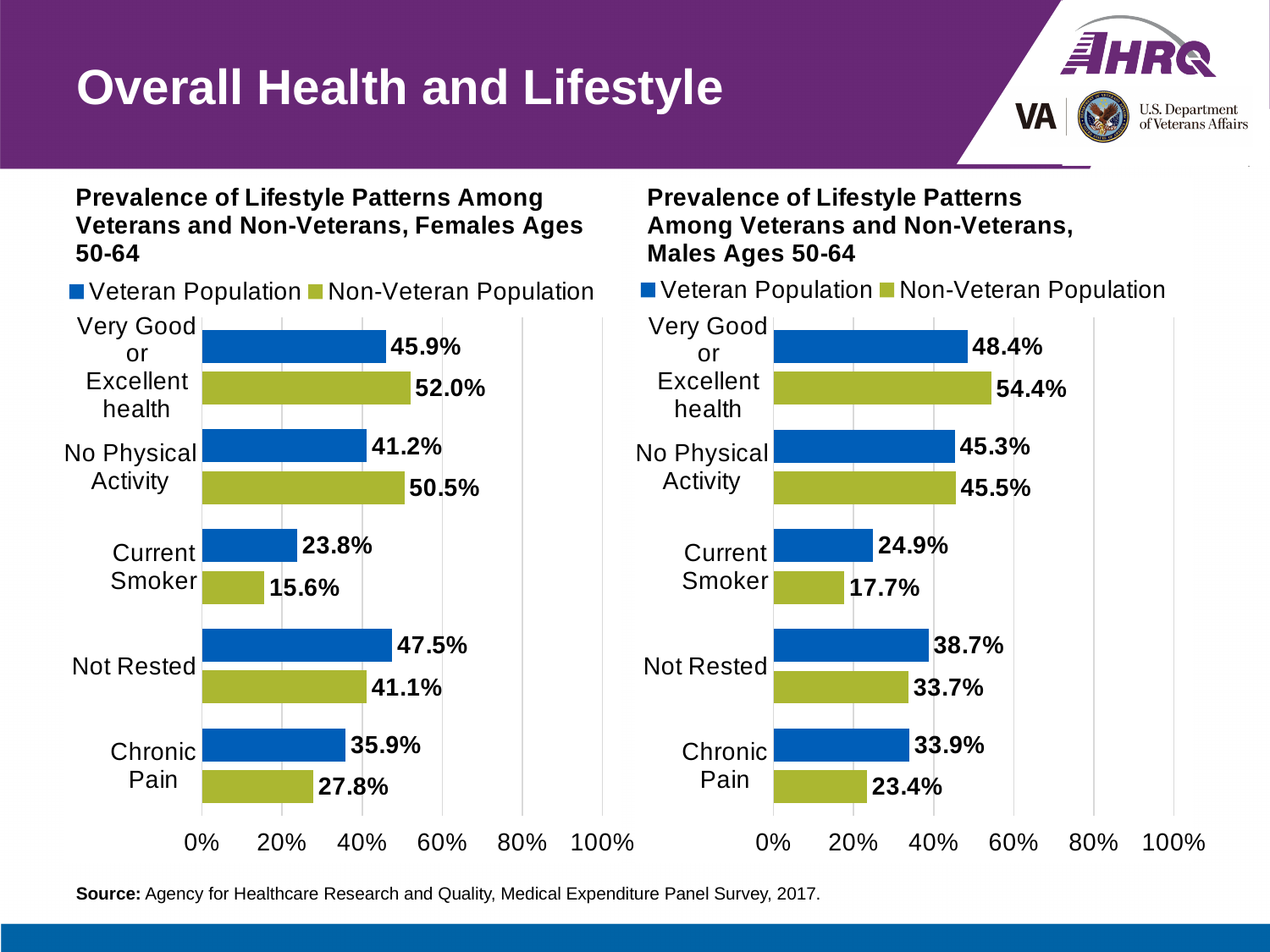
In the Females Ages 50-64 chart, which category has the highest Non-Veteran Population value? Very Good or Excellent health What kind of chart is the Females Ages 50-64 chart? Bar chart In the Males Ages 50-64 chart, which category has the lowest Non-Veteran Population value? Current Smoker In the Females Ages 50-64 chart, what is the difference between the Non-Veteran and Veteran Population values for No Physical Activity? 9.3% How many categories are shown in the Females Ages 50-64 chart? 5 In the Females Ages 50-64 chart, which is larger for Not Rested: the Veteran Population or the Non-Veteran Population value? Veteran Population In the Males Ages 50-64 chart, is the Veteran Population value for Very Good or Excellent health greater or less than 40%? greater In the Males Ages 50-64 chart, which colour represents the Non-Veteran Population? Green In the Males Ages 50-64 chart, what is the difference between the Veteran and Non-Veteran Population values for Not Rested? 5.0% In the Males Ages 50-64 chart, what is the value for Non-Veteran Population for Chronic Pain? 23.4% How many series does the legend of the Males Ages 50-64 chart list? 2 In the Females Ages 50-64 chart, what is the value for Veteran Population for Current Smoker? 23.8%